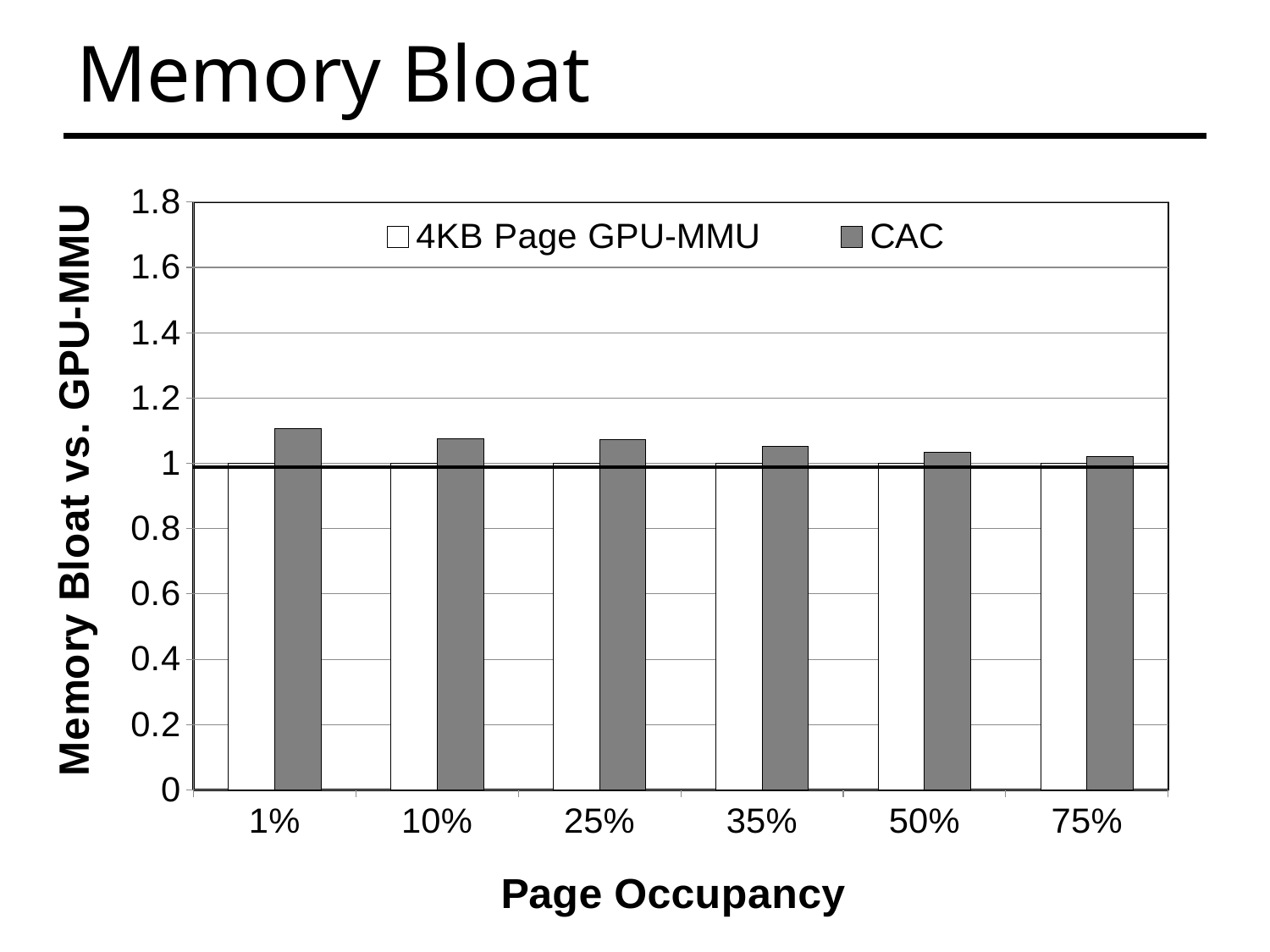
How many page occupancy categories are shown on the x axis? 6 What is the title of the y axis? Memory Bloat vs. GPU-MMU What is the value for 4KB Page GPU-MMU at 1% page occupancy? 1 At which page occupancy is the CAC value highest? 1% Is the CAC value at 1% page occupancy greater or less than 1? greater Is the CAC value at 1% page occupancy greater or less than 1.2? less Do the CAC values rise or fall as page occupancy increases along the x axis? fall How many series does the legend list? 2 What kind of chart is shown on the slide? bar chart At 1% page occupancy, which is larger: 4KB Page GPU-MMU or CAC? CAC What is the title of the x axis? Page Occupancy At which page occupancy is the CAC value lowest? 75%